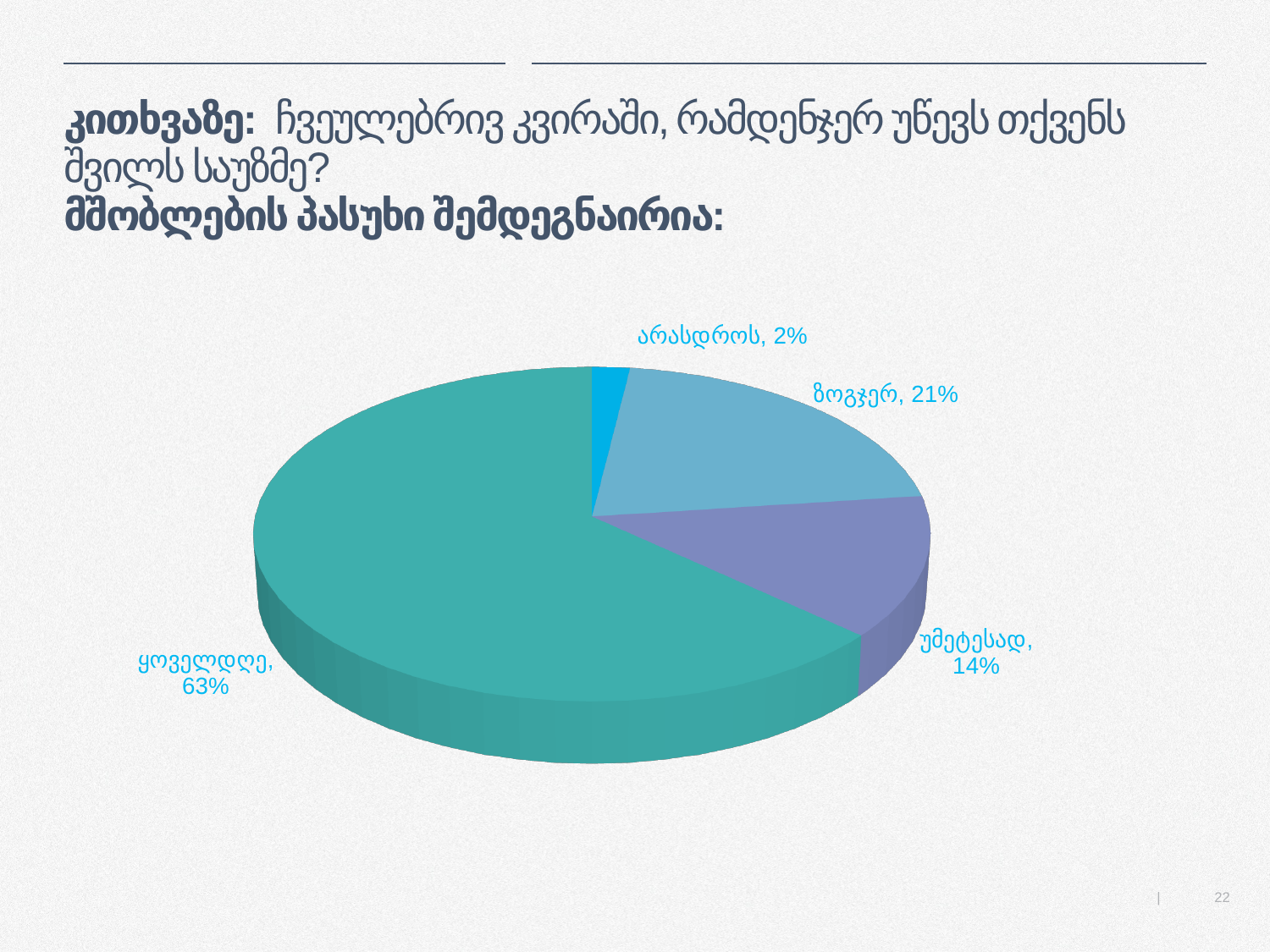
What is the difference in percentage points between ზოგჯერ and უმეტესად? 7 What percentage is shown for ზოგჯერ? 21% What share of the pie does ყოველდღე represent? 63% Which is larger, the slice for ზოგჯერ or the slice for უმეტესად? ზოგჯერ What kind of chart is shown on the slide? Pie chart What percentage is shown for უმეტესად? 14% What is the difference in percentage points between ყოველდღე and ზოგჯერ? 42 Which category has the smallest slice of the pie? არასდროს What is the combined share of ზოგჯერ and უმეტესად? 35% How many slices does the pie chart have? 4 Which category has the largest slice of the pie? ყოველდღე What percentage is shown for არასდროს? 2%